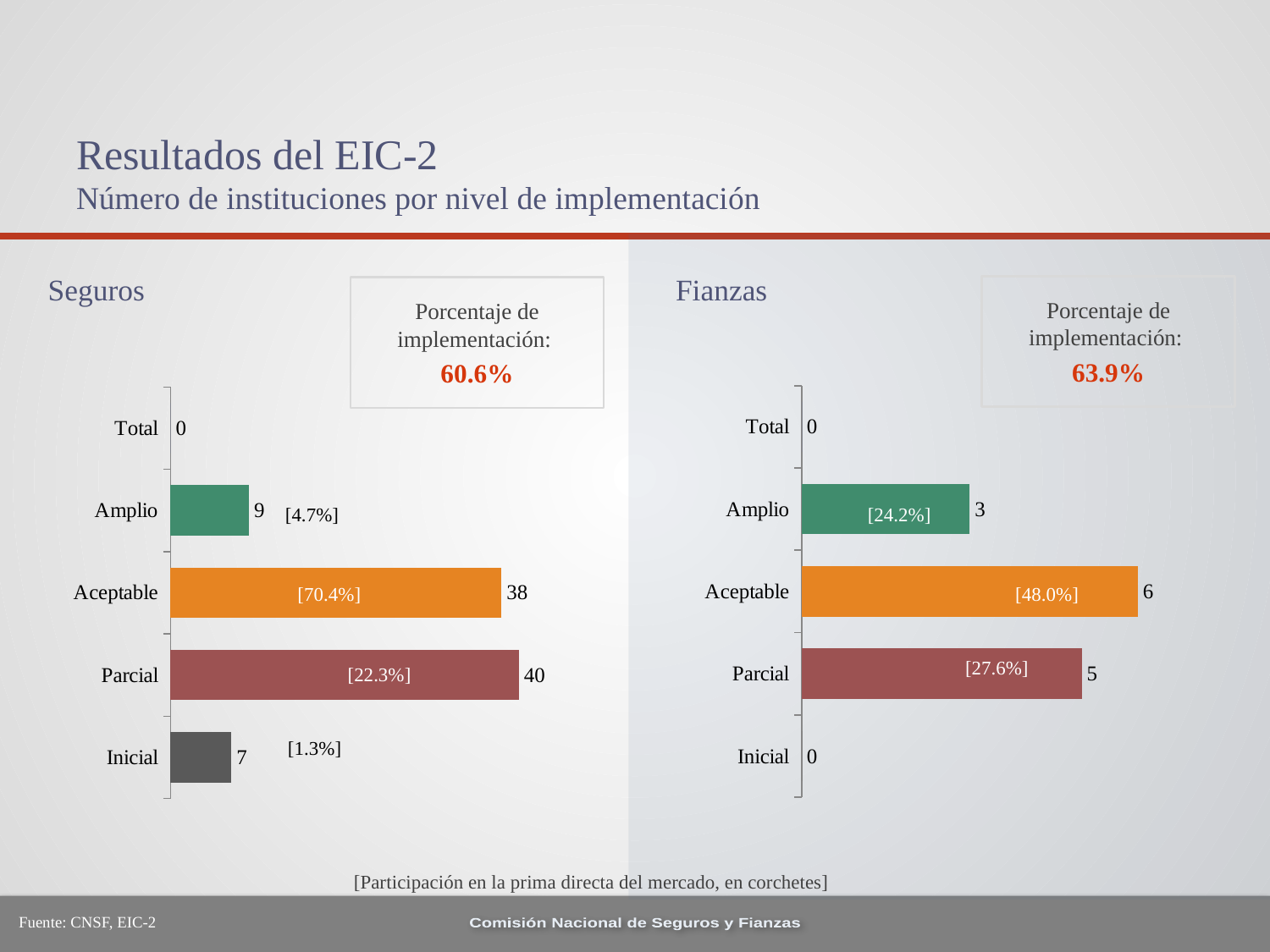
In the Seguros chart, what is the value for Parcial? 40 How many categories does the Fianzas chart show? 5 What kind of chart is the Seguros chart? Bar chart In the Fianzas chart, what is the difference between the values for Aceptable and Parcial? 1 In the Seguros chart, which category has the highest value? Parcial In the Seguros chart, what is the value for Aceptable? 38 In the Seguros chart, which is larger, the value for Amplio or the value for Inicial? Amplio In the Fianzas chart, what is the value for Aceptable? 6 What percentage of implementation is shown in the box next to the Fianzas chart? 63.9% In the Fianzas chart, which category has the highest value? Aceptable In the Fianzas chart, what is the value for Amplio? 3 In the Seguros chart, what is the difference between the values for Parcial and Aceptable? 2